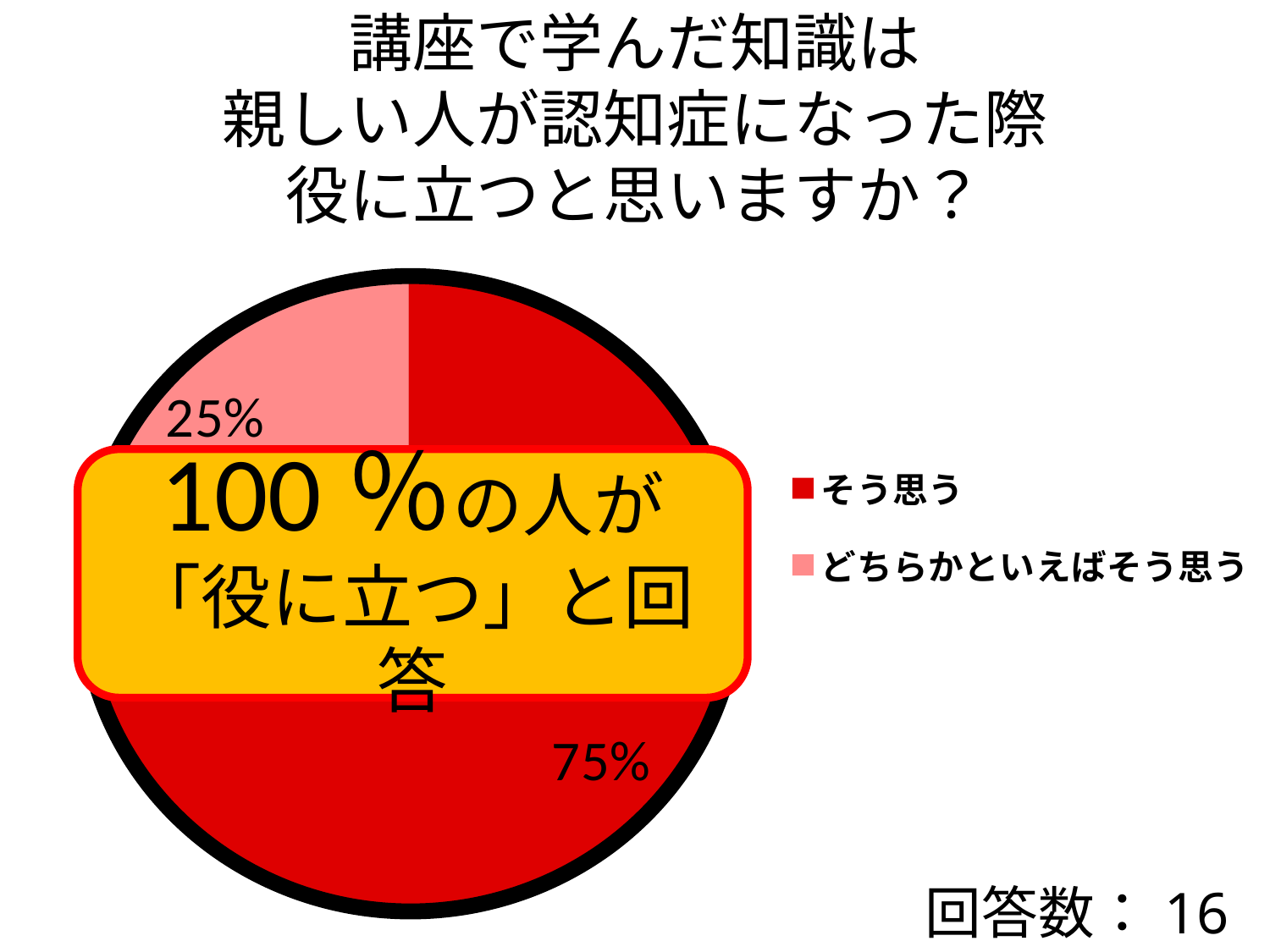
Which response category has the smallest share of the pie? どちらかといえばそう思う What is the combined share of 「そう思う」 and 「どちらかといえばそう思う」? 100% What percentage of respondents answered 「そう思う」? 75% What percentage of respondents answered 「どちらかといえばそう思う」? 25% How many responses (回答数) does the slide report? 16 What colour is the slice for 「どちらかといえばそう思う」? light pink How many slices does the pie chart have? 2 What is the difference in percentage points between 「そう思う」 and 「どちらかといえばそう思う」? 50 How many categories does the legend list? 2 What kind of chart is shown on the slide? pie chart Which response category has the largest share of the pie? そう思う Which is larger: the share for 「そう思う」 or the share for 「どちらかといえばそう思う」? そう思う